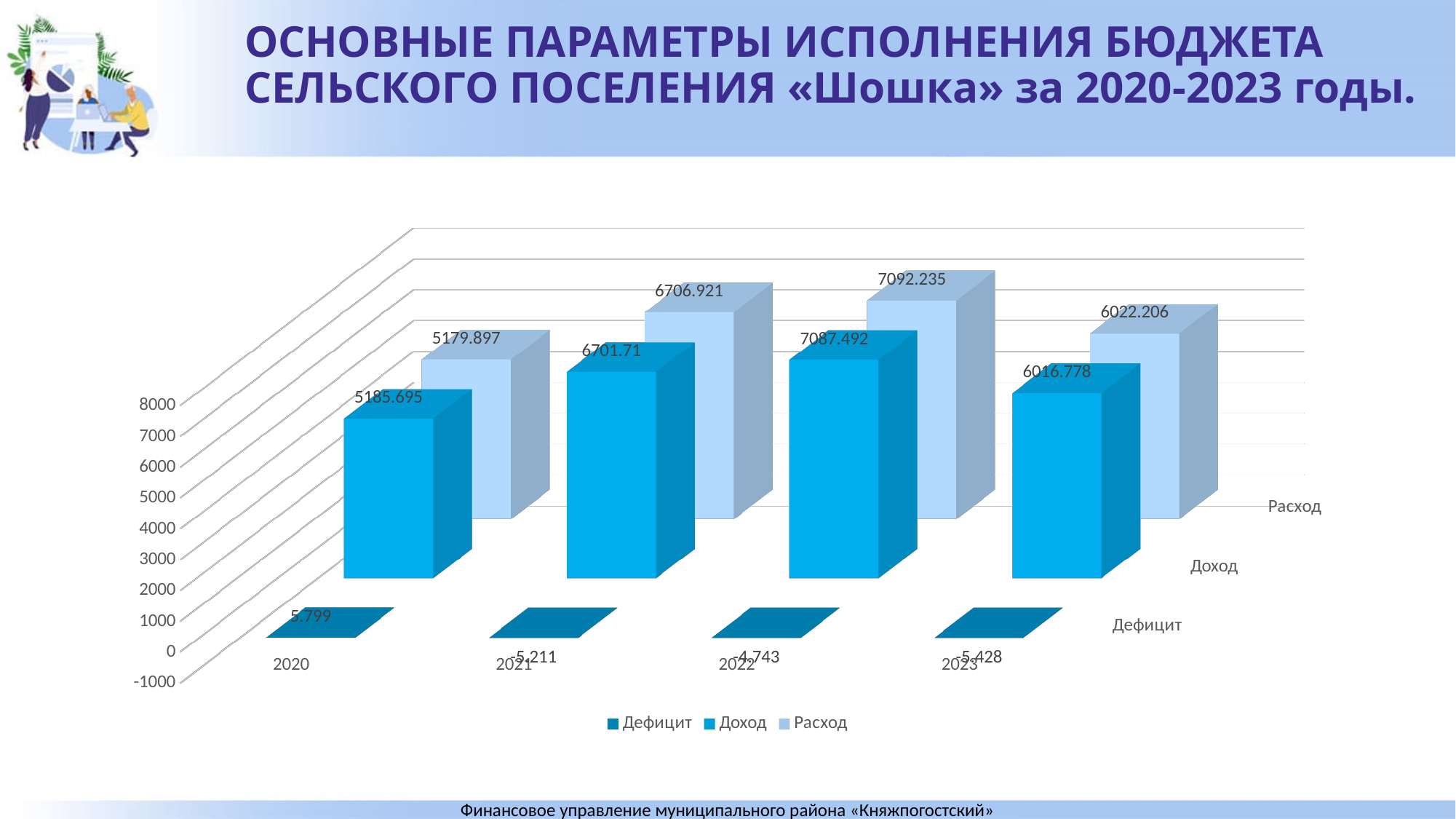
In which year is Расход the highest? 2022 What is the value of Расход for 2020? 5179.897 What is the value of Дефицит for 2020? 5.799 How many series does the legend list? 3 What is the value of Доход for 2022? 7087.492 What type of chart is shown on the slide? Bar chart In which year is Доход the lowest? 2020 Which is larger: Доход in 2021 or Доход in 2023? Доход in 2021 What is the difference between Расход in 2022 and Расход in 2020? 1912.338 How many years are shown on the x axis? 4 What is the value of Доход for 2023? 6016.778 What is the value of Расход for 2021? 6706.921